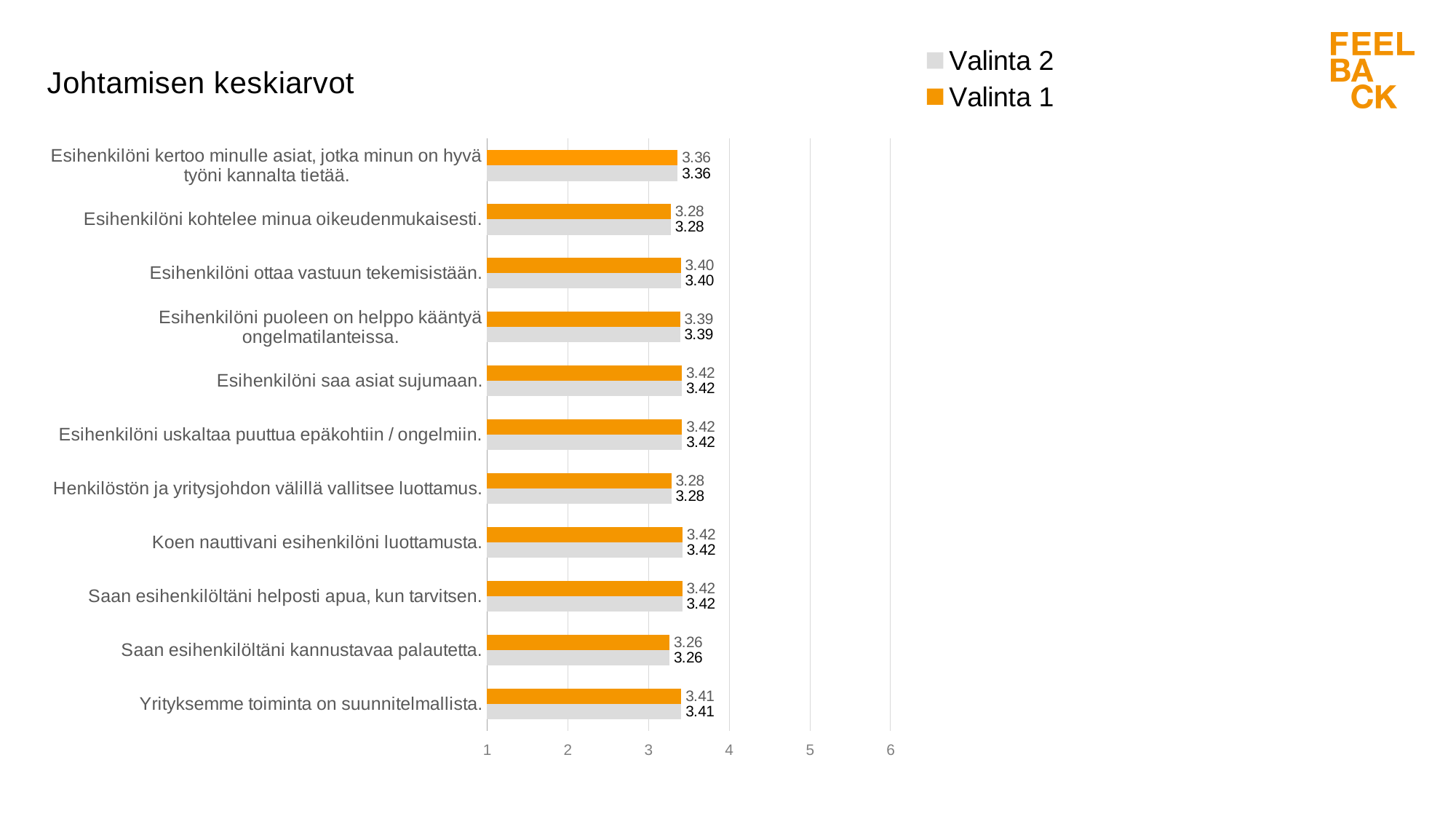
What is the highest Valinta 1 value shown in the chart? 3.42 What is the Valinta 1 value for "Yrityksemme toiminta on suunnitelmallista."? 3.41 What is the Valinta 2 value for "Esihenkilöni puoleen on helppo kääntyä ongelmatilanteissa."? 3.39 What is the Valinta 2 value for "Saan esihenkilöltäni kannustavaa palautetta."? 3.26 How many categories are shown in the chart? 11 What is the difference between the Valinta 1 values for "Esihenkilöni saa asiat sujumaan." and "Saan esihenkilöltäni kannustavaa palautetta."? 0.16 What is the Valinta 1 value for "Esihenkilöni ottaa vastuun tekemisistään."? 3.40 Which category has the lowest Valinta 1 value? Saan esihenkilöltäni kannustavaa palautetta. Is the Valinta 1 value for "Henkilöstön ja yritysjohdon välillä vallitsee luottamus." greater or less than 4? less How many series does the legend list? 2 Which has the larger Valinta 1 value: "Esihenkilöni ottaa vastuun tekemisistään." or "Esihenkilöni kohtelee minua oikeudenmukaisesti."? Esihenkilöni ottaa vastuun tekemisistään. What type of chart is shown on the slide? Bar chart